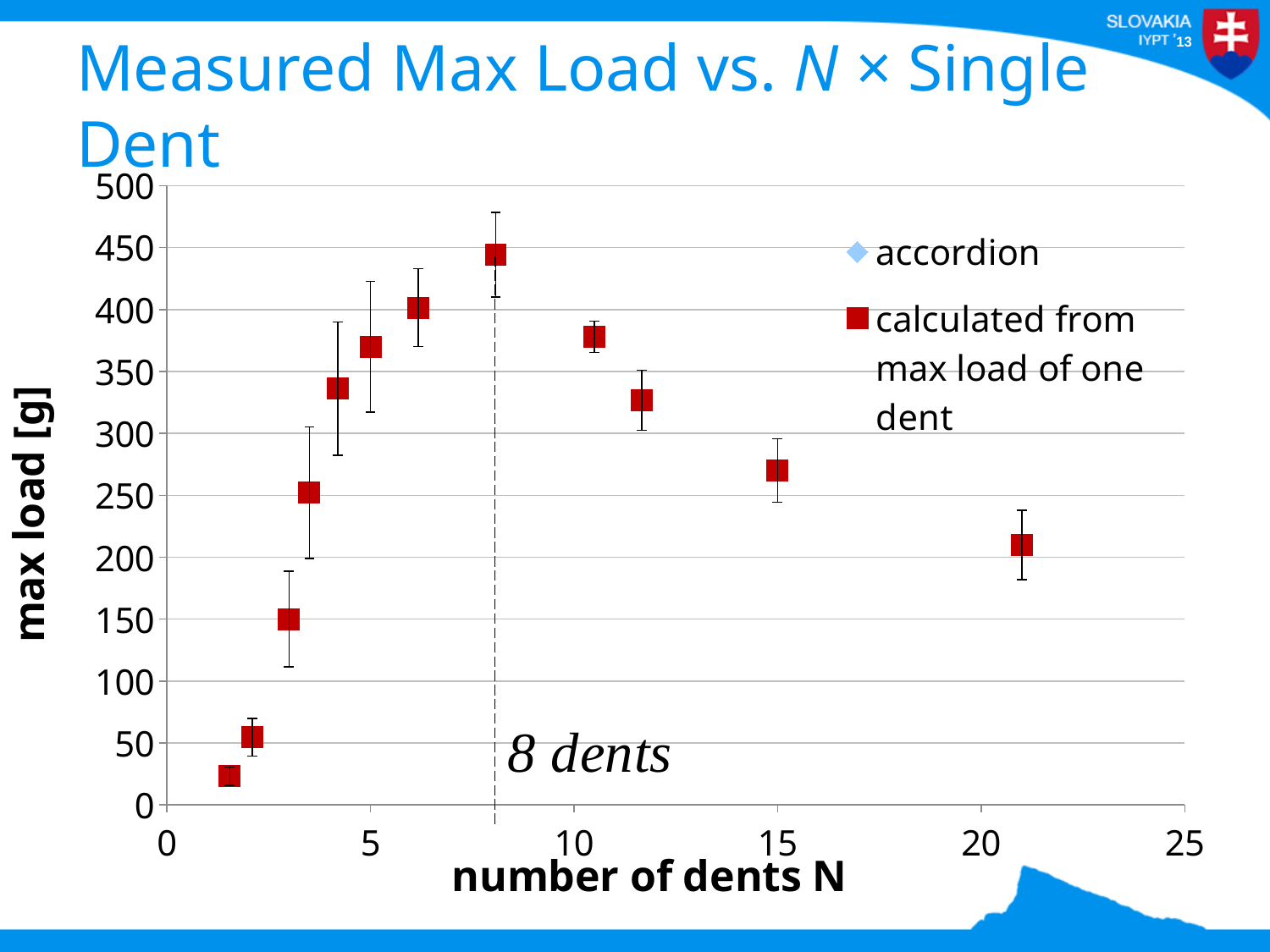
Is the max load at N = 21 greater or less than 250 g? less Is the max load at N = 15 greater or less than 300 g? less Which is larger, the max load at N = 6 or at N = 15? N = 6 Is the max load at N = 8 greater or less than 400 g? greater What is the label on the y axis? max load [g] What kind of chart is shown on the slide? scatter chart How many data points are plotted for the 'calculated from max load of one dent' series? 12 At which number of dents N is the plotted max load highest? 8 Do the max load values rise or fall as N increases from 8 to 21? fall How many series does the legend list? 2